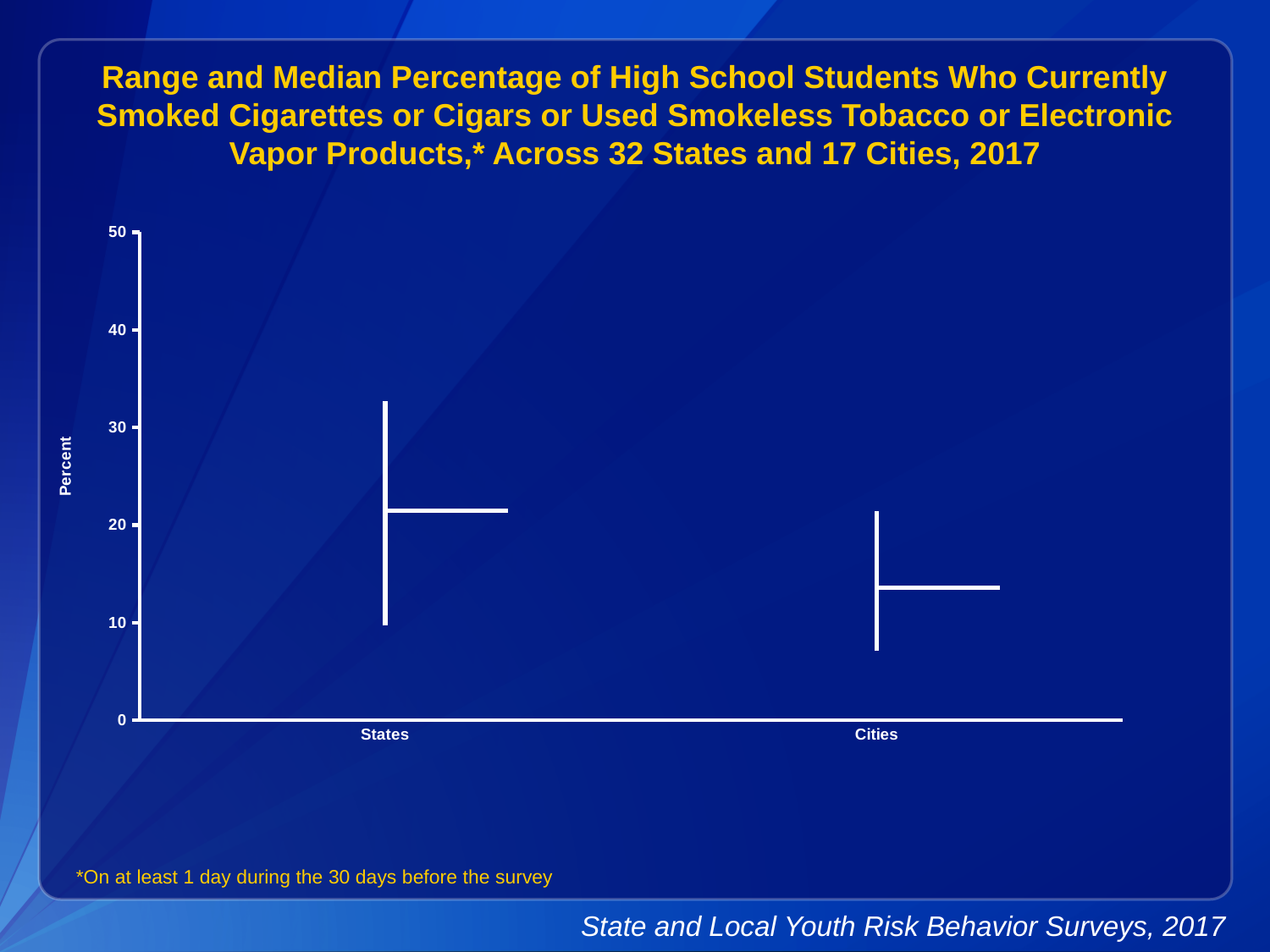
Is the top of the range for Cities greater or less than 30? less How many categories are shown on the x axis? 2 What are the two categories on the x axis? States and Cities Which category has the higher top of its range, States or Cities? States Is the median value for States greater or less than 20? greater Is the median value for Cities greater or less than 10? greater What is the maximum value shown on the y axis? 50 Which category has the higher median value, States or Cities? States What is the label of the y axis? Percent